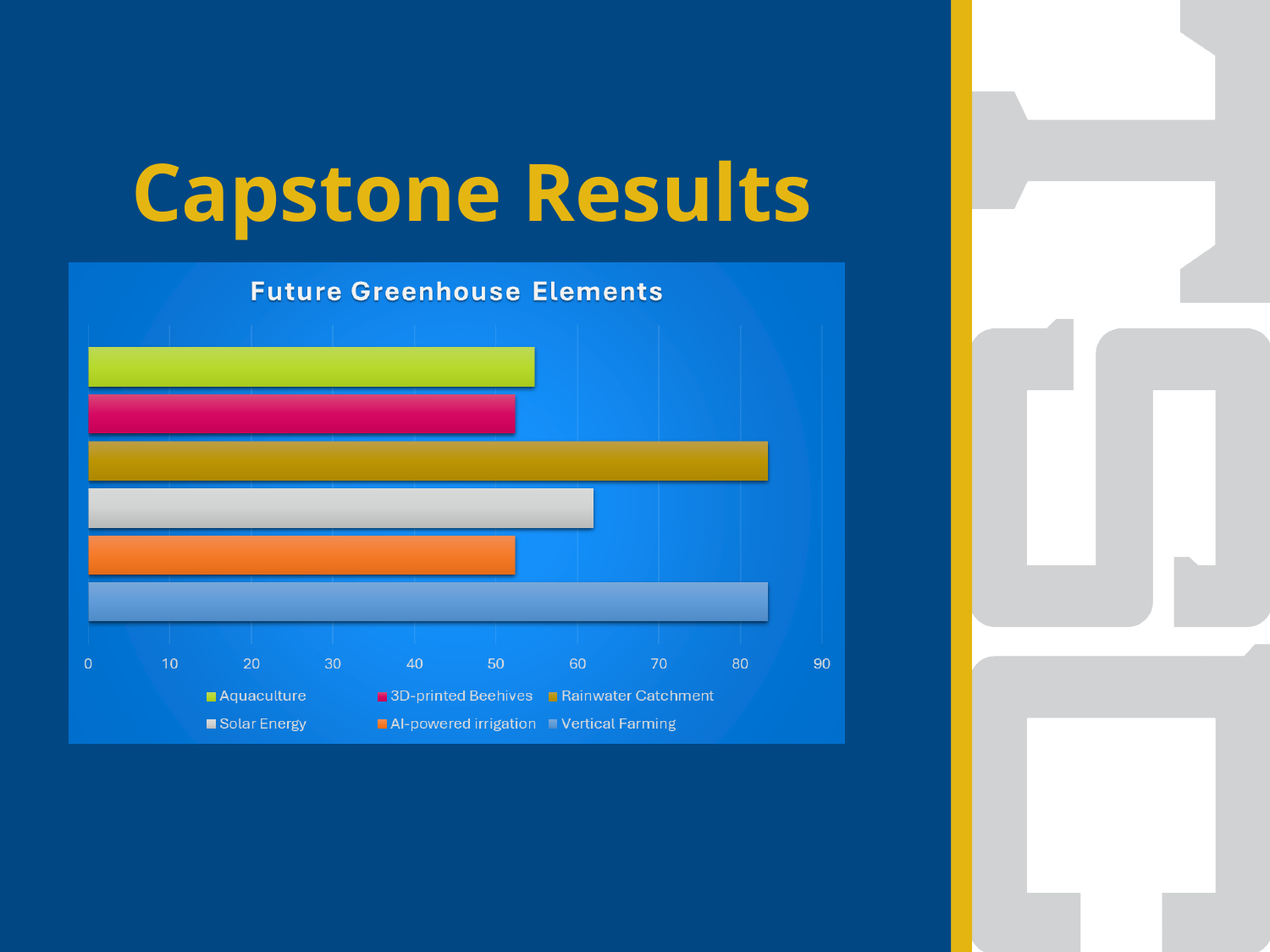
Is the value for AI-powered irrigation greater or less than 60? less Is the value for Aquaculture greater or less than 60? less Is the value for Solar Energy greater or less than 70? less How many bars are plotted in the chart? 6 What type of chart is shown on the slide? Bar chart How many entries does the chart's legend list? 6 Which is larger, the value for Rainwater Catchment or the value for Aquaculture? Rainwater Catchment Which is larger, the value for Solar Energy or the value for 3D-printed Beehives? Solar Energy What is the title of the chart? Future Greenhouse Elements